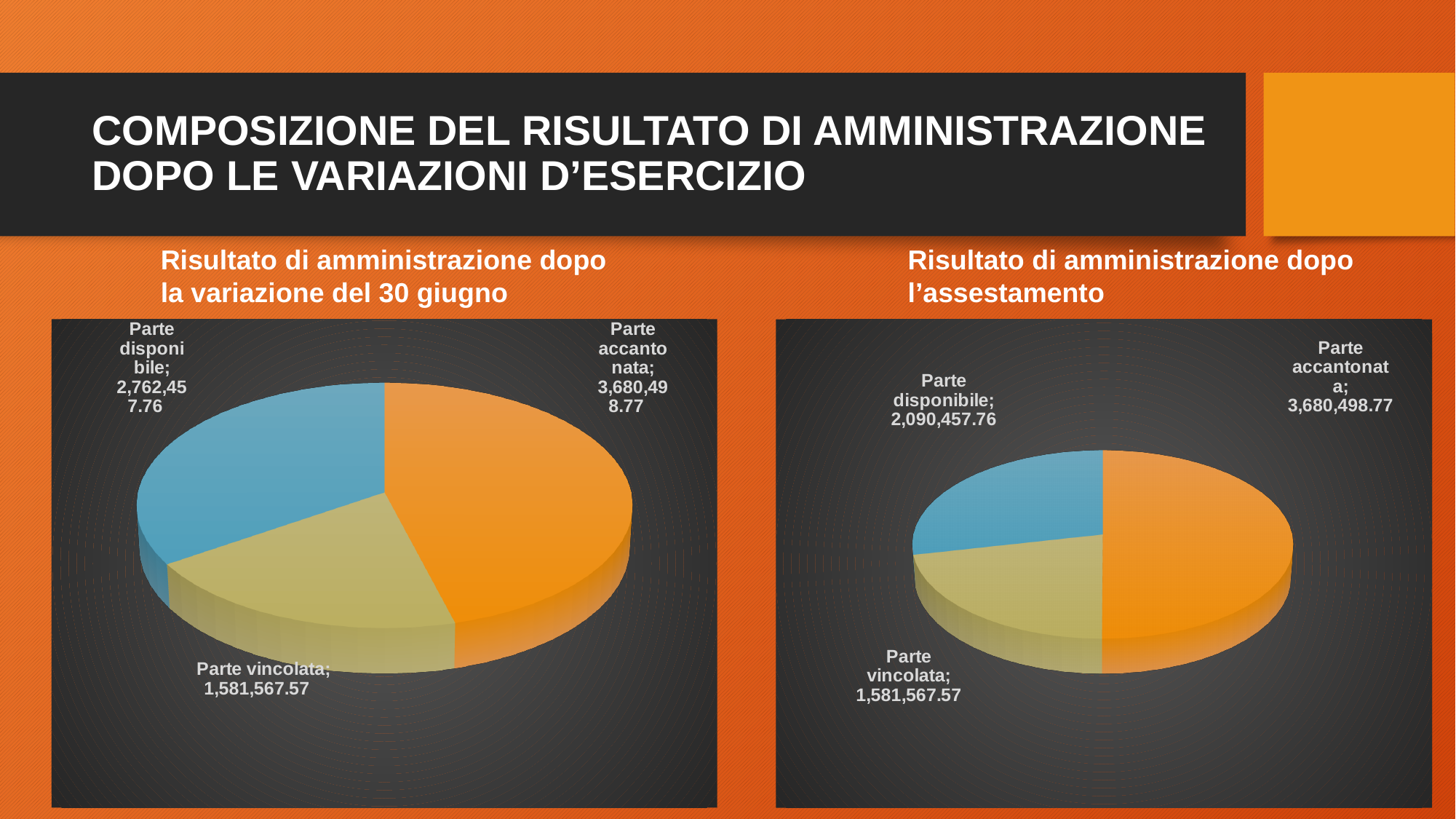
Is Parte disponibile larger in the left chart (dopo la variazione del 30 giugno) or in the right chart (dopo l'assestamento)? Left chart (dopo la variazione del 30 giugno) In the left chart (Risultato di amministrazione dopo la variazione del 30 giugno), what is the value of Parte accantonata? 3,680,498.77 How many slices does the right chart (Risultato di amministrazione dopo l'assestamento) have? 3 In the left chart (Risultato di amministrazione dopo la variazione del 30 giugno), which slice is the largest? Parte accantonata In the left chart (Risultato di amministrazione dopo la variazione del 30 giugno), what is the value of Parte disponibile? 2,762,457.76 In the left chart (Risultato di amministrazione dopo la variazione del 30 giugno), what is the difference between Parte accantonata and Parte disponibile? 918,041.01 What is the title of the right chart on the slide? Risultato di amministrazione dopo l'assestamento What type of chart is the left chart (Risultato di amministrazione dopo la variazione del 30 giugno)? Pie chart In the right chart (Risultato di amministrazione dopo l'assestamento), what is the value of Parte vincolata? 1,581,567.57 In the right chart (Risultato di amministrazione dopo l'assestamento), which slice is the smallest? Parte vincolata In the right chart (Risultato di amministrazione dopo l'assestamento), what is the value of Parte disponibile? 2,090,457.76 In the right chart (Risultato di amministrazione dopo l'assestamento), what is the difference between Parte accantonata and Parte disponibile? 1,590,041.01